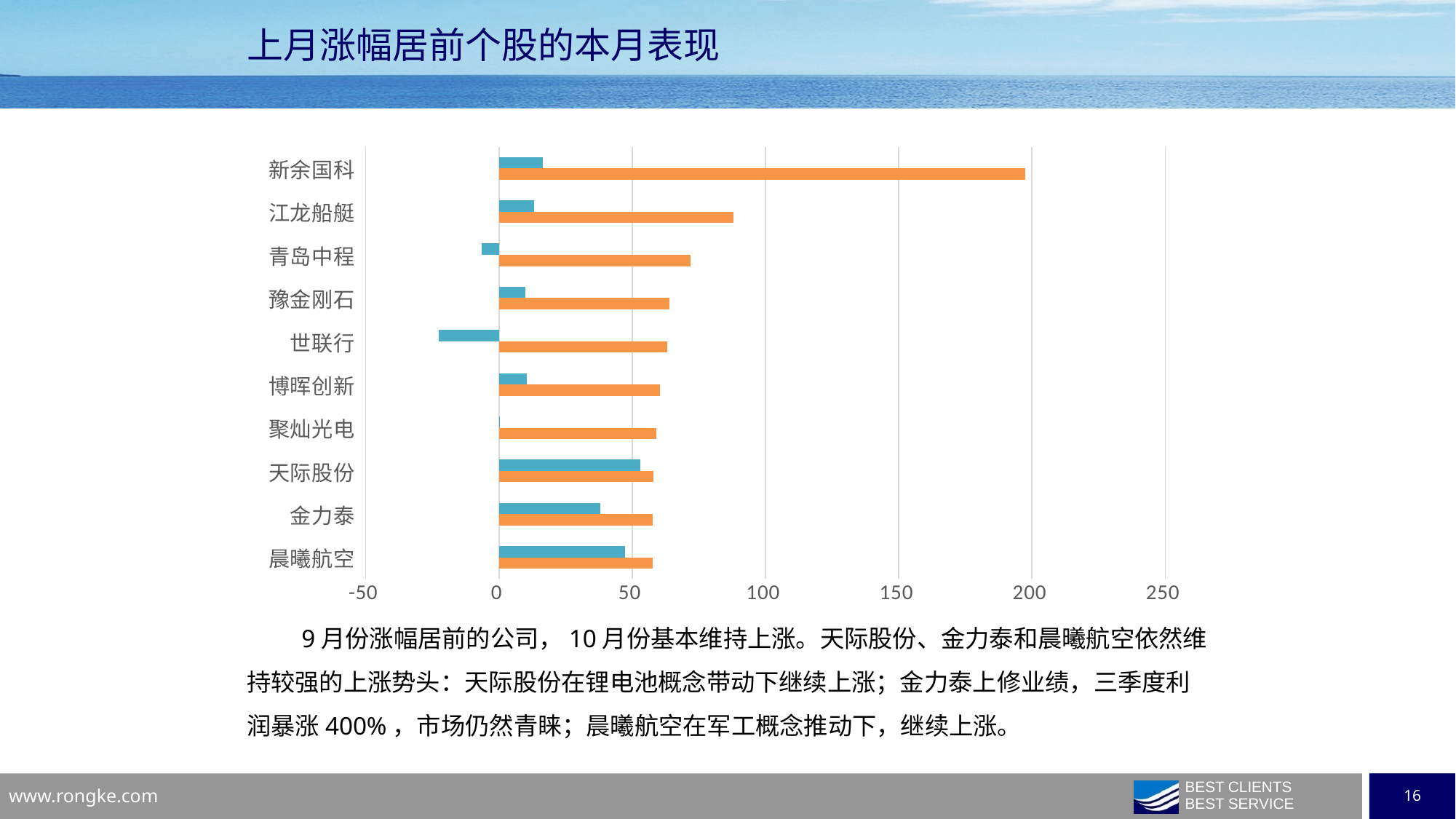
Is the blue bar value for 世联行 greater or less than 0? less How many stocks (categories) are listed on the chart? 10 Which stock has the lowest (most negative) blue bar? 世联行 Which has the larger orange bar value, 新余国科 or 江龙船艇? 新余国科 What is the title of the slide's chart? 上月涨幅居前个股的本月表现 Is the blue bar value for 金力泰 greater or less than 50? less Which stock has the longest orange bar? 新余国科 What kind of chart is shown on the slide? Bar chart Which two colours are used for the bars in the chart? Blue and orange Is the orange bar value for 青岛中程 greater or less than 50? greater